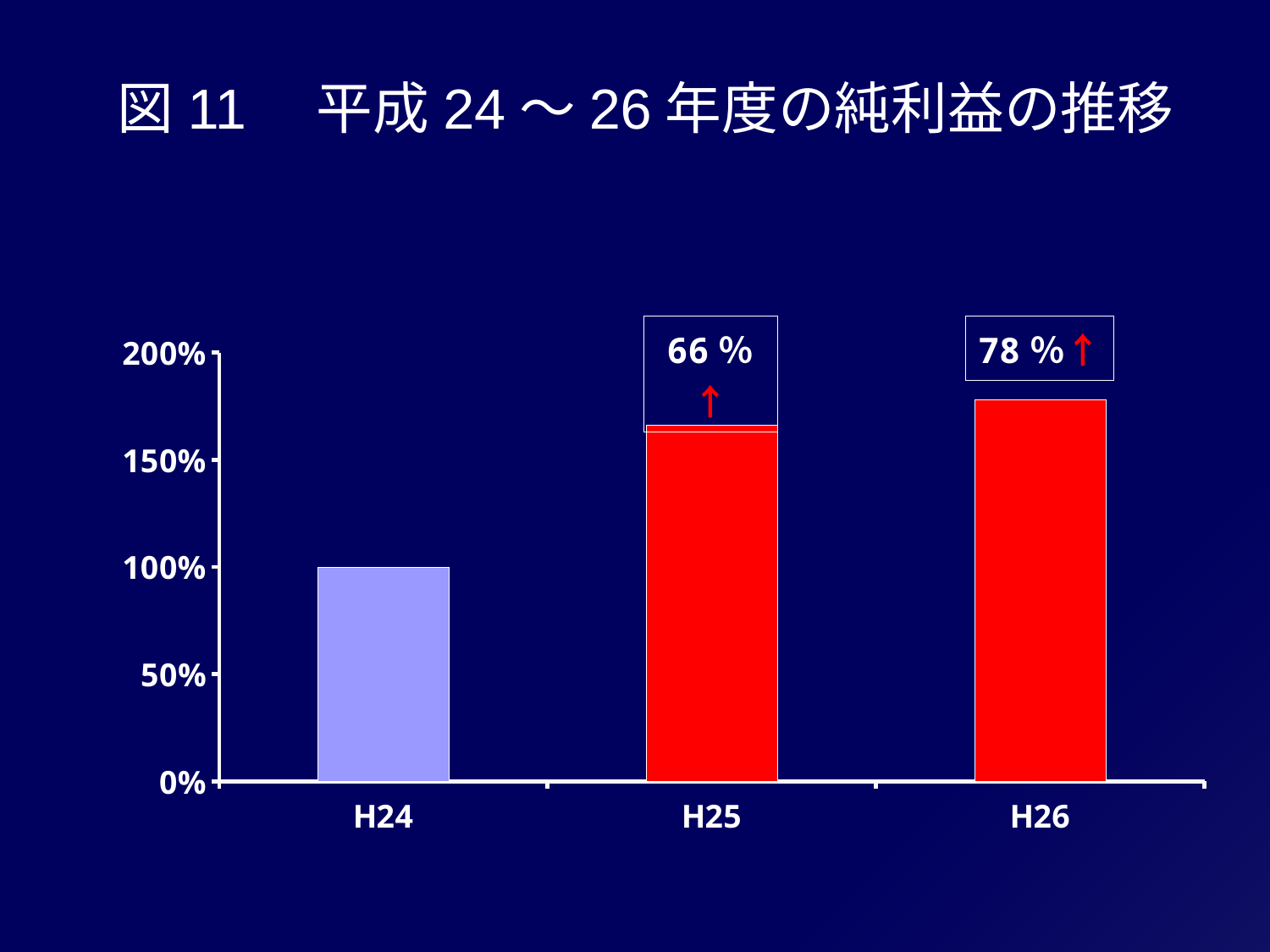
Is the value for H25 greater or less than 150%? greater Is the value for H26 greater or less than 200%? less Is the value for H25 greater or less than 200%? less What annotation is printed above the H26 bar? 78 %↑ Which category has the lowest bar? H24 What annotation is printed above the H25 bar? 66 %↑ Do the bar values rise or fall from H24 to H26? rise Which category has the highest bar? H26 What is the value of the bar for H24? 100% How many categories are shown on the x axis of the chart? 3 What kind of chart is shown on the slide? bar chart Which bar is taller, H25 or H26? H26